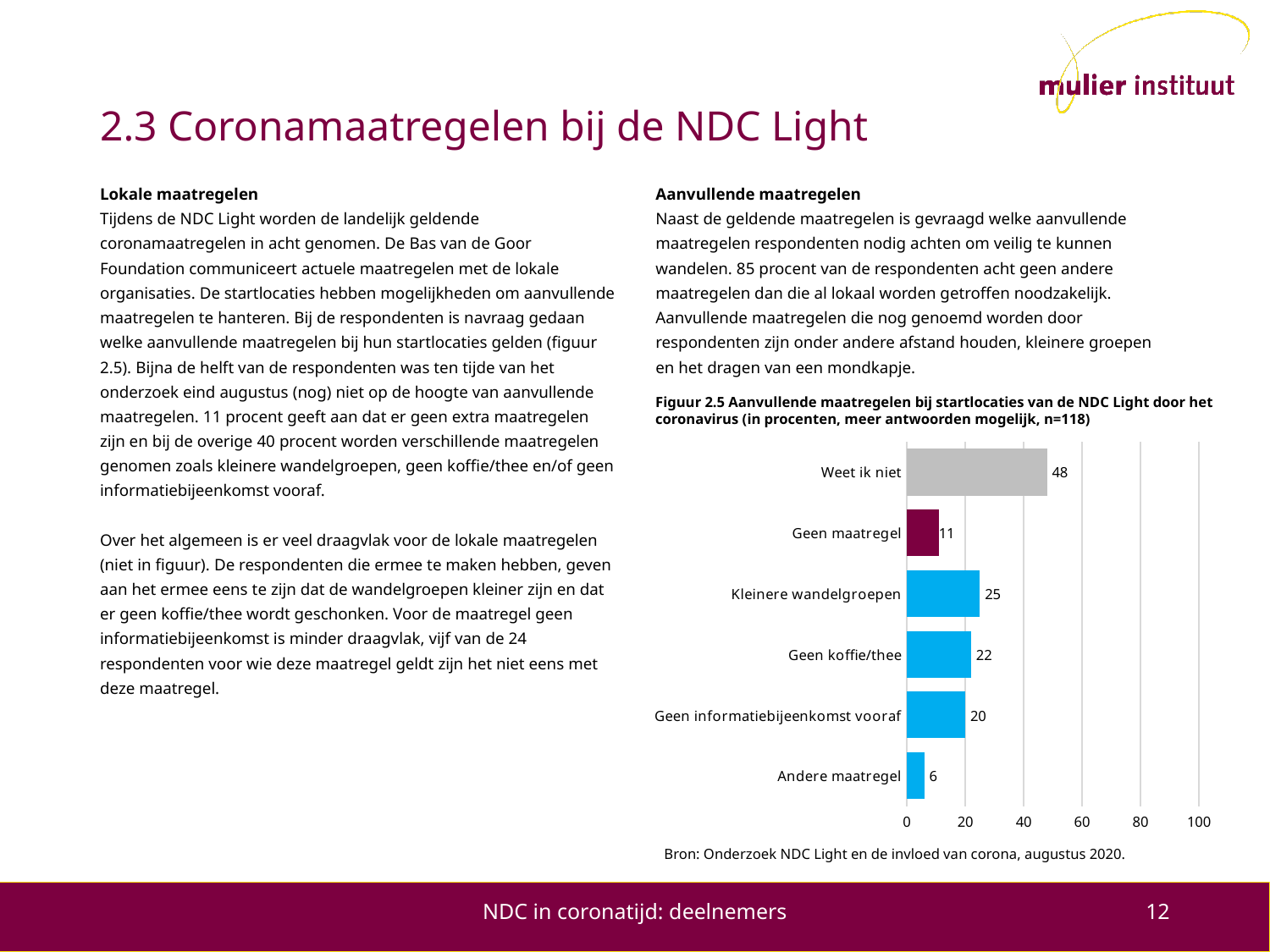
What is the value for 'Andere maatregel' in the chart? 6 What is the difference between the values for 'Weet ik niet' and 'Geen maatregel'? 37 Which category has the lowest value in the chart? Andere maatregel Is the value for 'Weet ik niet' greater or less than 40? greater Which is larger: the value for 'Kleinere wandelgroepen' or the value for 'Geen informatiebijeenkomst vooraf'? Kleinere wandelgroepen What is the value for 'Kleinere wandelgroepen' in the chart? 25 What is the value for 'Geen koffie/thee' in the chart? 22 What is the value for 'Weet ik niet' in the chart? 48 Which category has the highest value in the chart? Weet ik niet How many categories are shown in the chart? 6 What kind of chart is shown on the slide? Bar chart What is the sample size (n) stated in the chart title? n=118